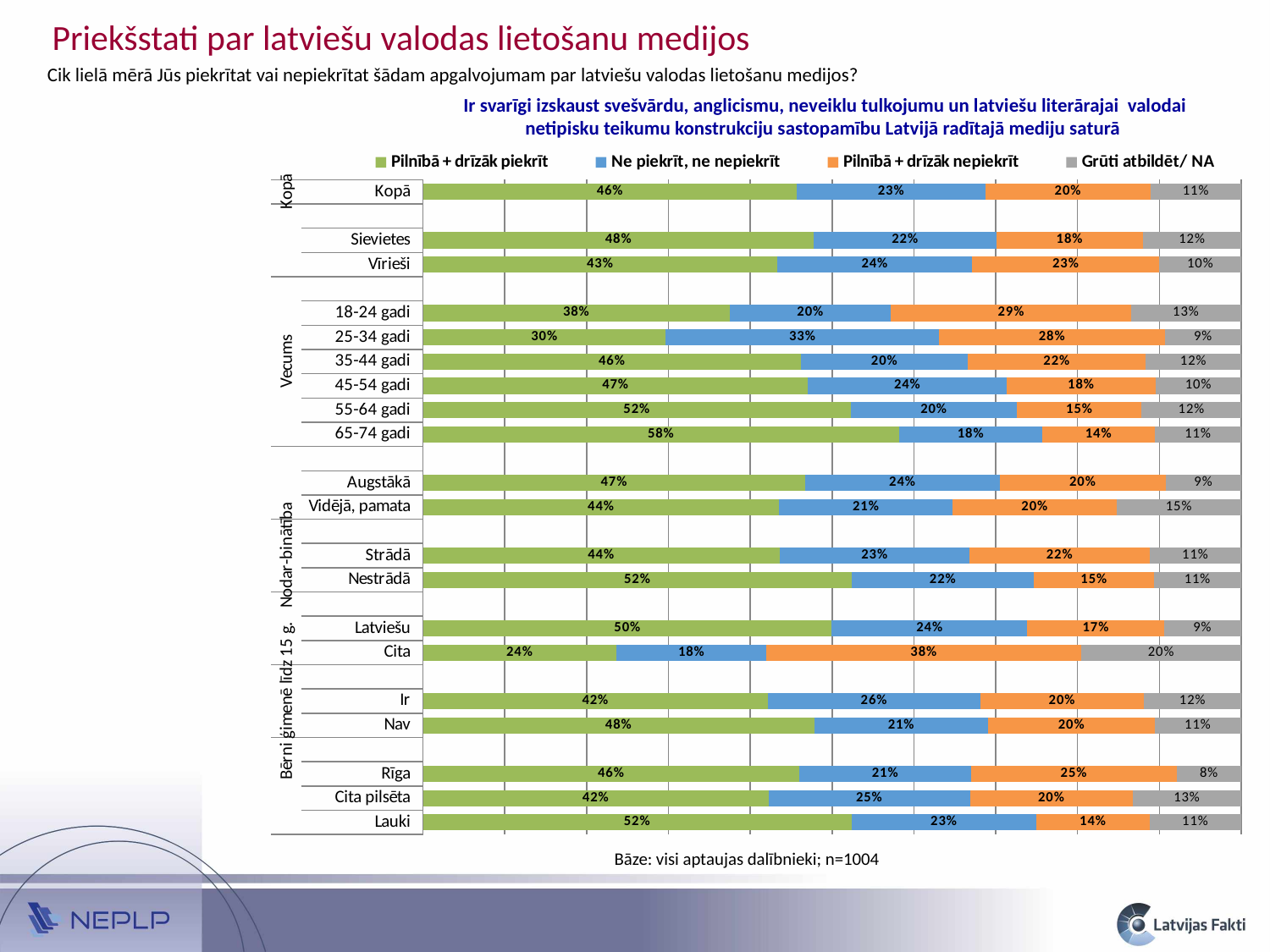
What is the value of "Pilnībā + drīzāk nepiekrīt" for 18-24 gadi? 29% Which category has the lowest value for "Grūti atbildēt/ NA"? Rīga Which category has the lowest value for "Pilnībā + drīzāk piekrīt"? Cita What is the value of "Grūti atbildēt/ NA" for Vidējā, pamata? 15% How many series does the legend list? 4 What kind of chart is shown on the slide? stacked bar chart Which category has the highest value for "Pilnībā + drīzāk piekrīt"? 65-74 gadi Which has a larger "Ne piekrīt, ne nepiekrīt" value, 25-34 gadi or 65-74 gadi? 25-34 gadi What is the difference between the "Pilnībā + drīzāk piekrīt" values for Sievietes and Vīrieši? 5 percentage points What is the total of the stacked bar for Kopā? 100% What is the value of "Pilnībā + drīzāk piekrīt" for Kopā? 46% How many categories (rows) are plotted in the chart? 20